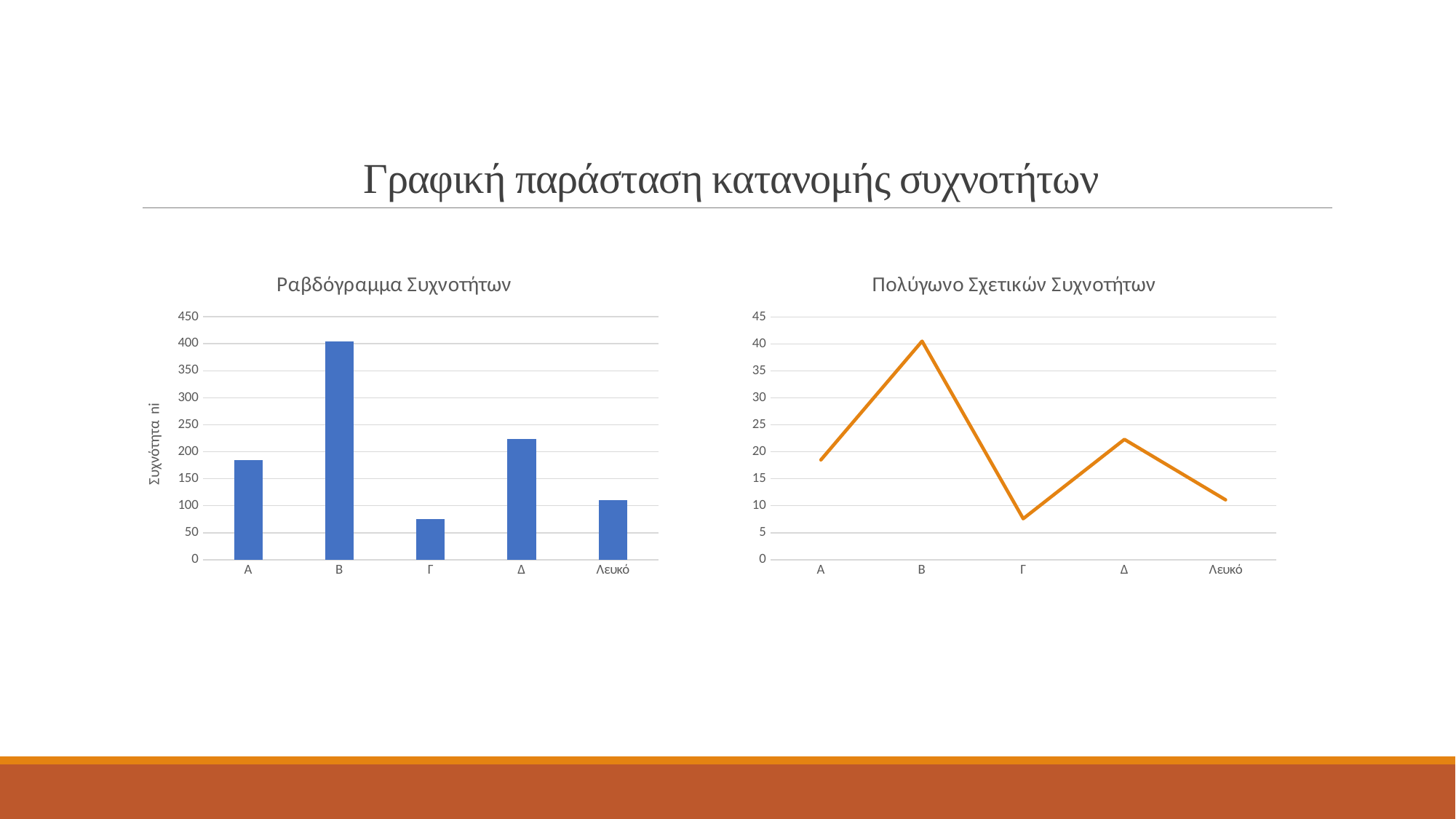
In the chart titled "Ραβδόγραμμα Συχνοτήτων", is the value for Γ greater or less than 100? less In the chart titled "Πολύγωνο Σχετικών Συχνοτήτων", is the value for Β greater or less than 35? greater What kind of chart is the chart titled "Πολύγωνο Σχετικών Συχνοτήτων"? line chart In the chart titled "Πολύγωνο Σχετικών Συχνοτήτων", which category has the lowest value? Γ In the chart titled "Ραβδόγραμμα Συχνοτήτων", which is larger, the value for Α or the value for Δ? Δ In the chart titled "Ραβδόγραμμα Συχνοτήτων", which category has the highest bar? Β In the chart titled "Πολύγωνο Σχετικών Συχνοτήτων", which category has the highest value? Β What is the y-axis label of the chart titled "Ραβδόγραμμα Συχνοτήτων"? Συχνότητα ni How many categories are shown on the x axis of the chart titled "Ραβδόγραμμα Συχνοτήτων"? 5 In the chart titled "Ραβδόγραμμα Συχνοτήτων", which category has the lowest bar? Γ In the chart titled "Ραβδόγραμμα Συχνοτήτων", is the value for Β greater or less than 350? greater What kind of chart is the chart titled "Ραβδόγραμμα Συχνοτήτων"? bar chart